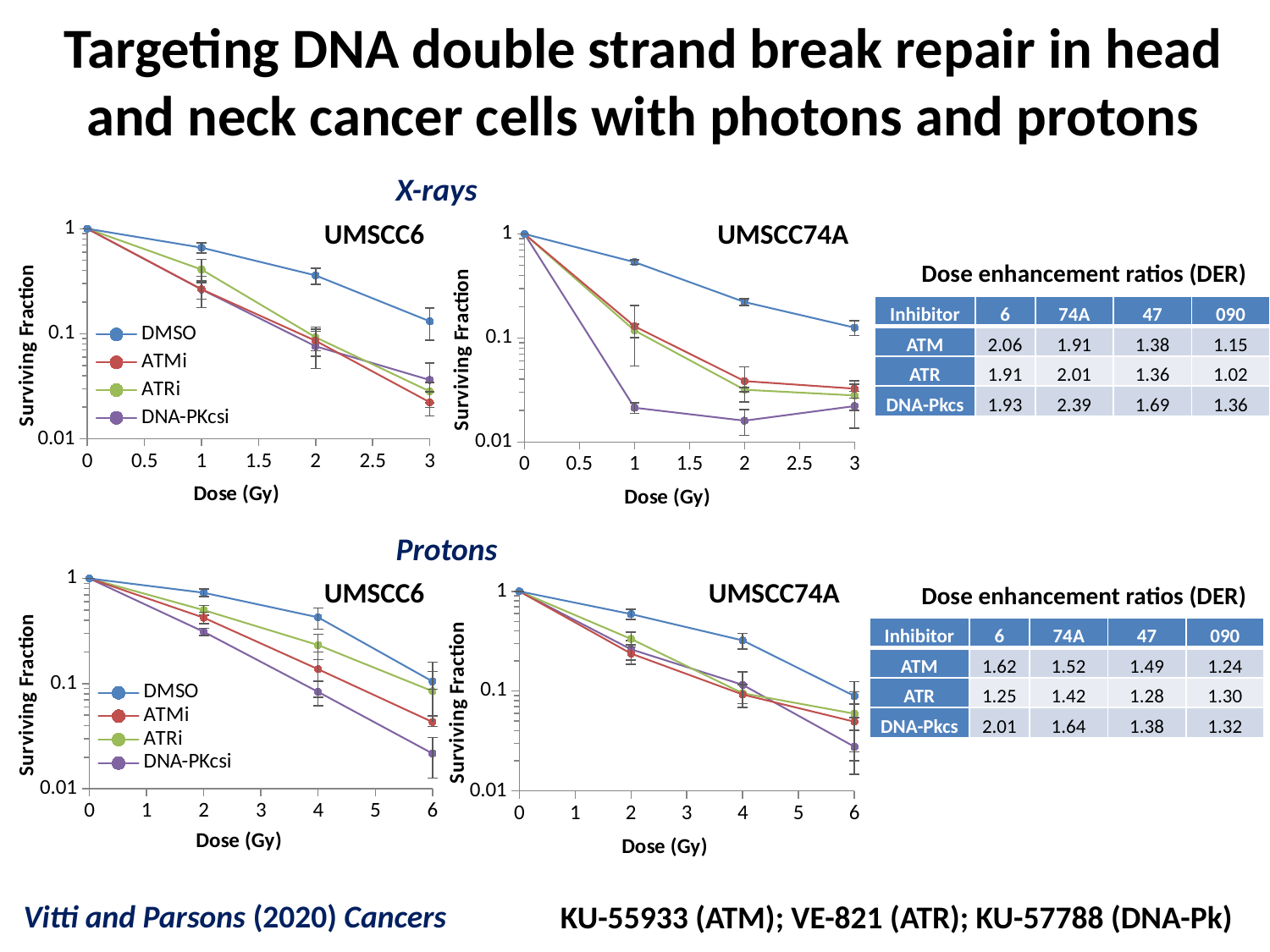
What is the x-axis title of the X-rays UMSCC6 chart? Dose (Gy) How many series does the legend of the X-rays UMSCC6 chart list? 4 In the X-rays UMSCC74A chart, which has the larger surviving fraction at 1 Gy, DMSO or DNA-PKcsi? DMSO In the Protons UMSCC74A chart, what is the surviving fraction of all series at 0 Gy? 1 In the Protons UMSCC6 chart, is the DMSO surviving fraction at 4 Gy greater or less than 0.1? greater What kind of chart is the X-rays UMSCC6 chart? line chart In the Protons UMSCC6 chart, is the DNA-PKcsi surviving fraction at 6 Gy greater or less than 0.1? less In the X-rays UMSCC74A chart, is the DNA-PKcsi surviving fraction at 1 Gy greater or less than 0.1? less In the X-rays UMSCC6 chart, which series has the highest surviving fraction at 3 Gy? DMSO In the X-rays UMSCC74A chart, does the DMSO surviving fraction rise or fall as dose increases? fall How many dose points are plotted for each series in the Protons UMSCC6 chart? 4 In the X-rays UMSCC74A chart, which series has the lowest surviving fraction at 2 Gy? DNA-PKcsi